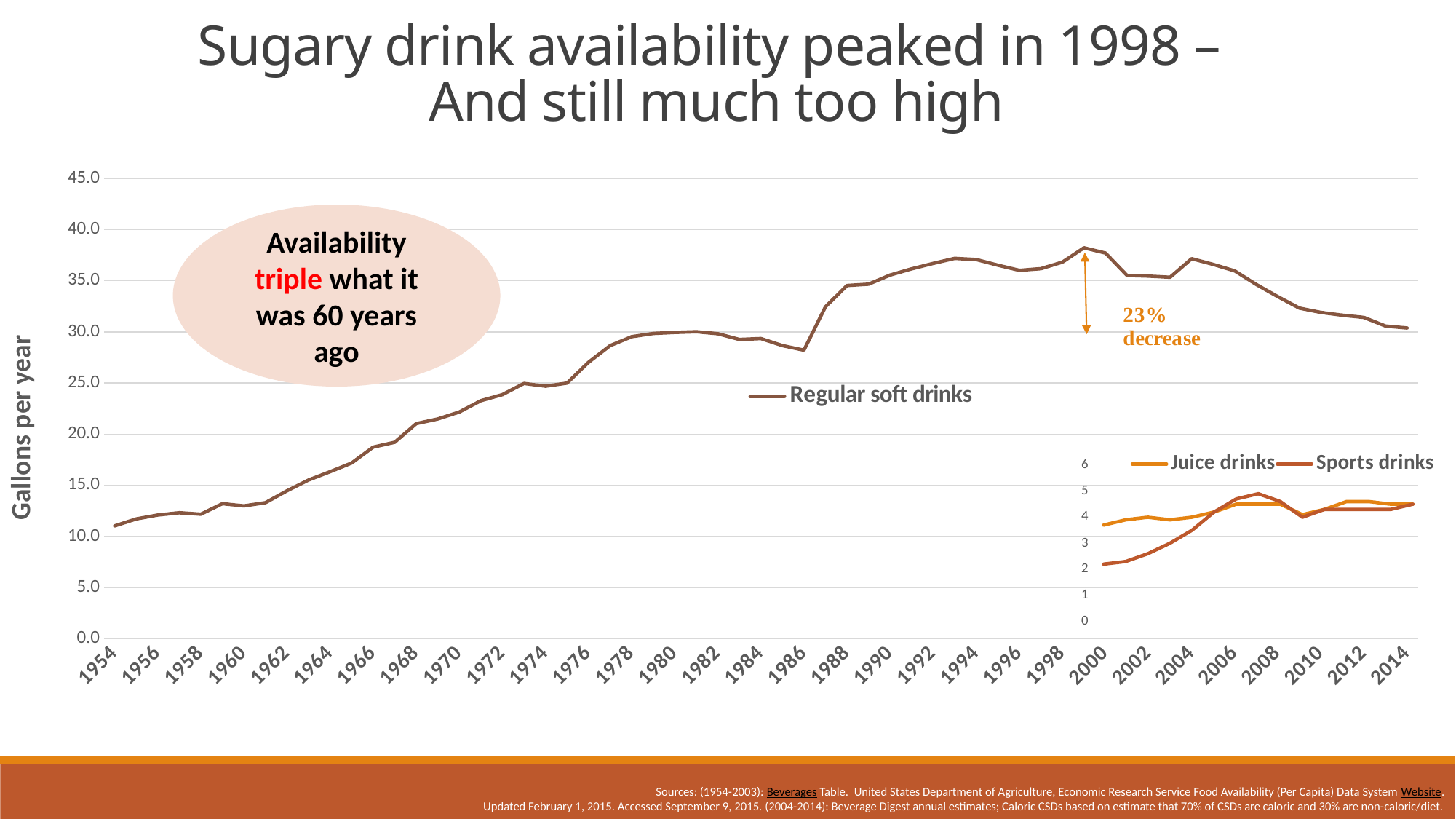
How many series does the legend of the small inset chart list? 2 In the main chart, does the Regular soft drinks line rise or fall between 1954 and 1998? rise In the main chart, is the Regular soft drinks value for 1986 greater or less than 30.0? less What kind of chart is the main chart on the slide? line chart In the main chart, does the Regular soft drinks line rise or fall between 1998 and 2014? fall In the main chart, is the Regular soft drinks value for 1954 greater or less than 15.0? less What is the label on the vertical axis of the main chart? Gallons per year In the main chart, in which year is the Regular soft drinks value lowest? 1954 In the main chart, is the Regular soft drinks value for 2014 greater or less than 35.0? less In the inset chart, which series has the higher value in 2000, Juice drinks or Sports drinks? Juice drinks In the main chart, in which year does the Regular soft drinks line reach its highest value? 1999